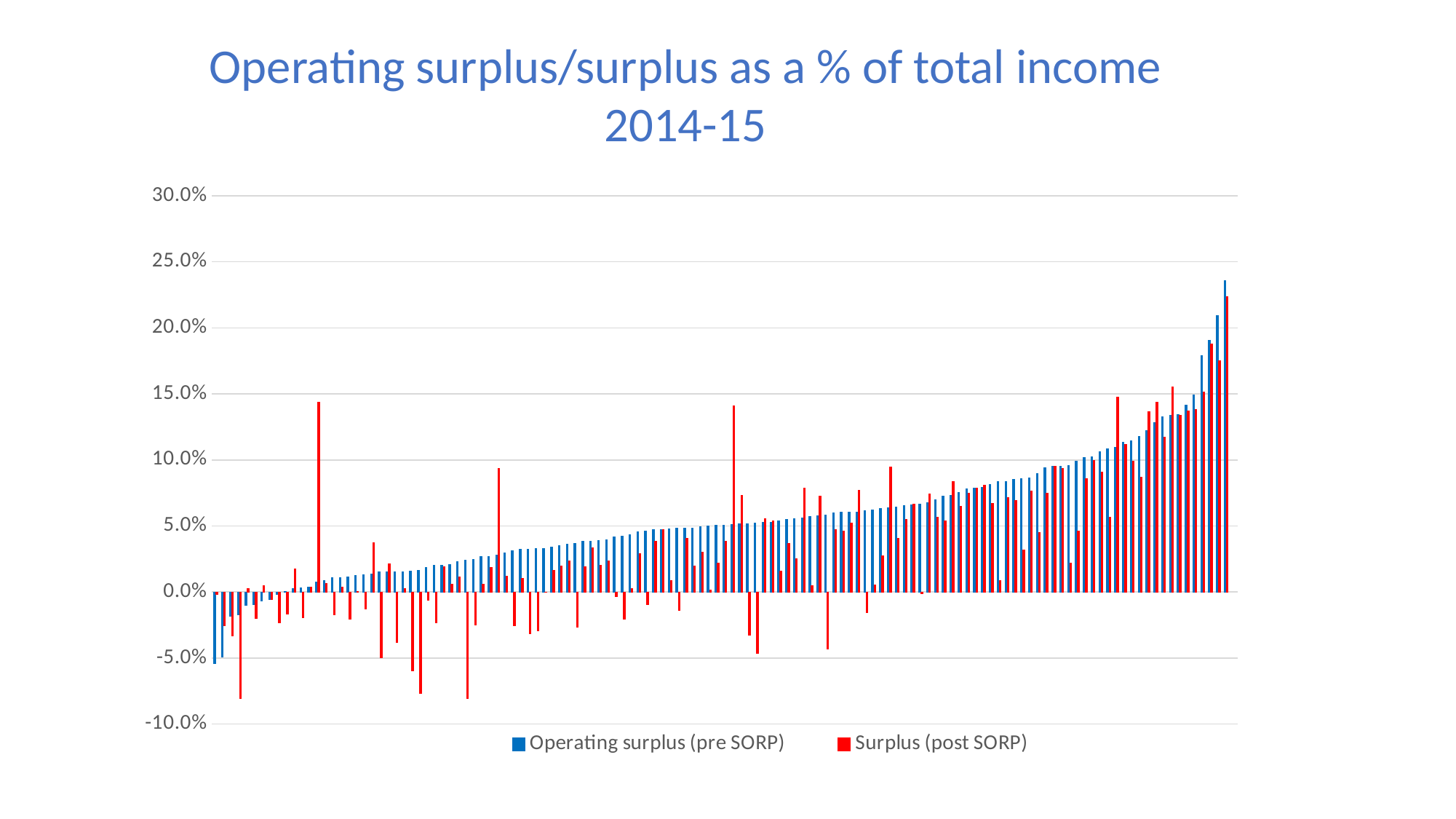
How many series does the legend list? 2 What is the title of the chart? Operating surplus/surplus as a % of total income 2014-15 Is the lowest red Surplus (post SORP) bar greater or less than -5.0%? less Do the blue Operating surplus (pre SORP) bars rise or fall from left to right? Rise Is the tallest blue Operating surplus (pre SORP) bar greater or less than 20.0%? greater Is the lowest blue Operating surplus (pre SORP) bar greater or less than -10.0%? greater What kind of chart is shown on the slide? Bar chart Which series contains the tallest bar on the chart, Operating surplus (pre SORP) or Surplus (post SORP)? Operating surplus (pre SORP) Which series is shown in red? Surplus (post SORP) Which series reaches the lowest value on the chart, Operating surplus (pre SORP) or Surplus (post SORP)? Surplus (post SORP)